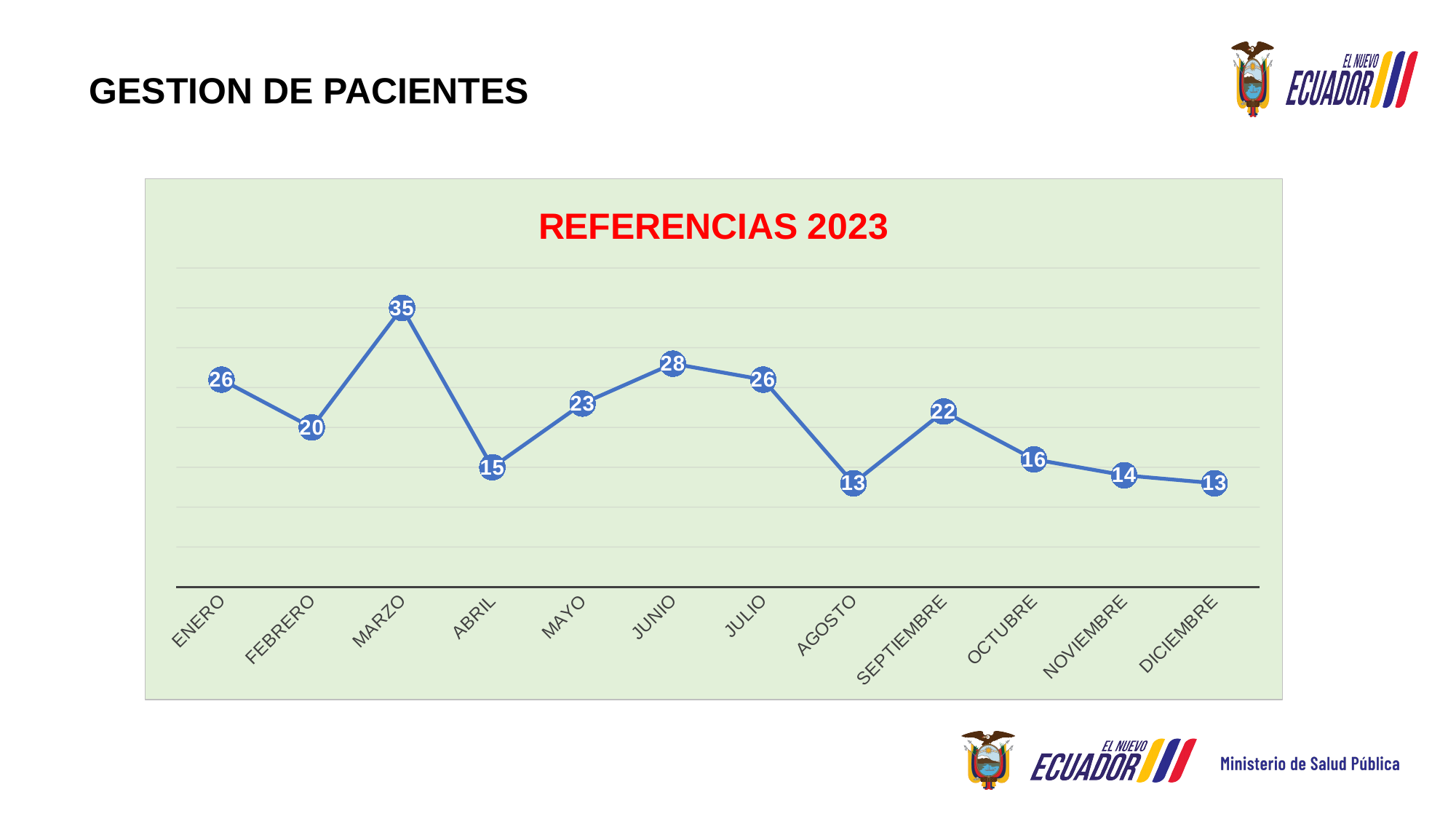
What is the title of the chart? REFERENCIAS 2023 How many months are plotted on the chart? 12 What is the difference between the values for MARZO and ABRIL? 20 What is the value for AGOSTO? 13 What is the difference between the values for ENERO and FEBRERO? 6 What is the value for NOVIEMBRE? 14 Do the values rise or fall from SEPTIEMBRE to DICIEMBRE? fall Which is larger, the value for JUNIO or the value for JULIO? JUNIO What kind of chart is shown? line chart Which month has the highest value? MARZO What is the value for MARZO? 35 What is the value for SEPTIEMBRE? 22